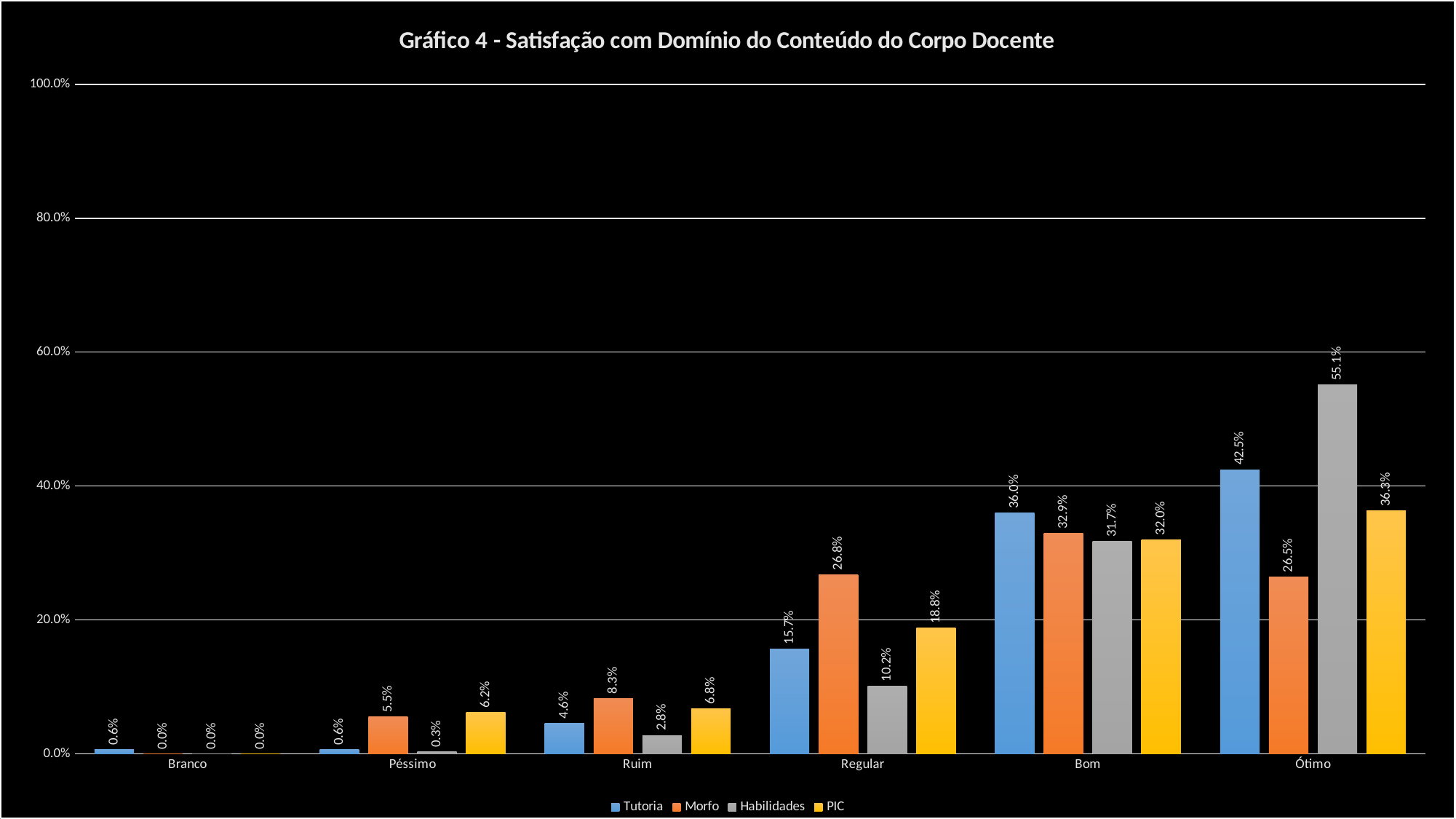
Which is larger in the Bom category, Tutoria or Morfo? Tutoria Which series has the highest value in the Ótimo category? Habilidades What kind of chart is shown on the slide? Bar chart What is the value for Morfo in the Regular category? 26.8% What is the value for Tutoria in the Ruim category? 4.6% What is the value for PIC in the Bom category? 32.0% What is the title of the chart? Gráfico 4 - Satisfação com Domínio do Conteúdo do Corpo Docente What is the value for Habilidades in the Ótimo category? 55.1% What is the difference between the Tutoria and Morfo values in the Ótimo category? 16.0% Which series has the lowest value in the Regular category? Habilidades How many series does the legend list? 4 How many categories are shown on the x axis? 6